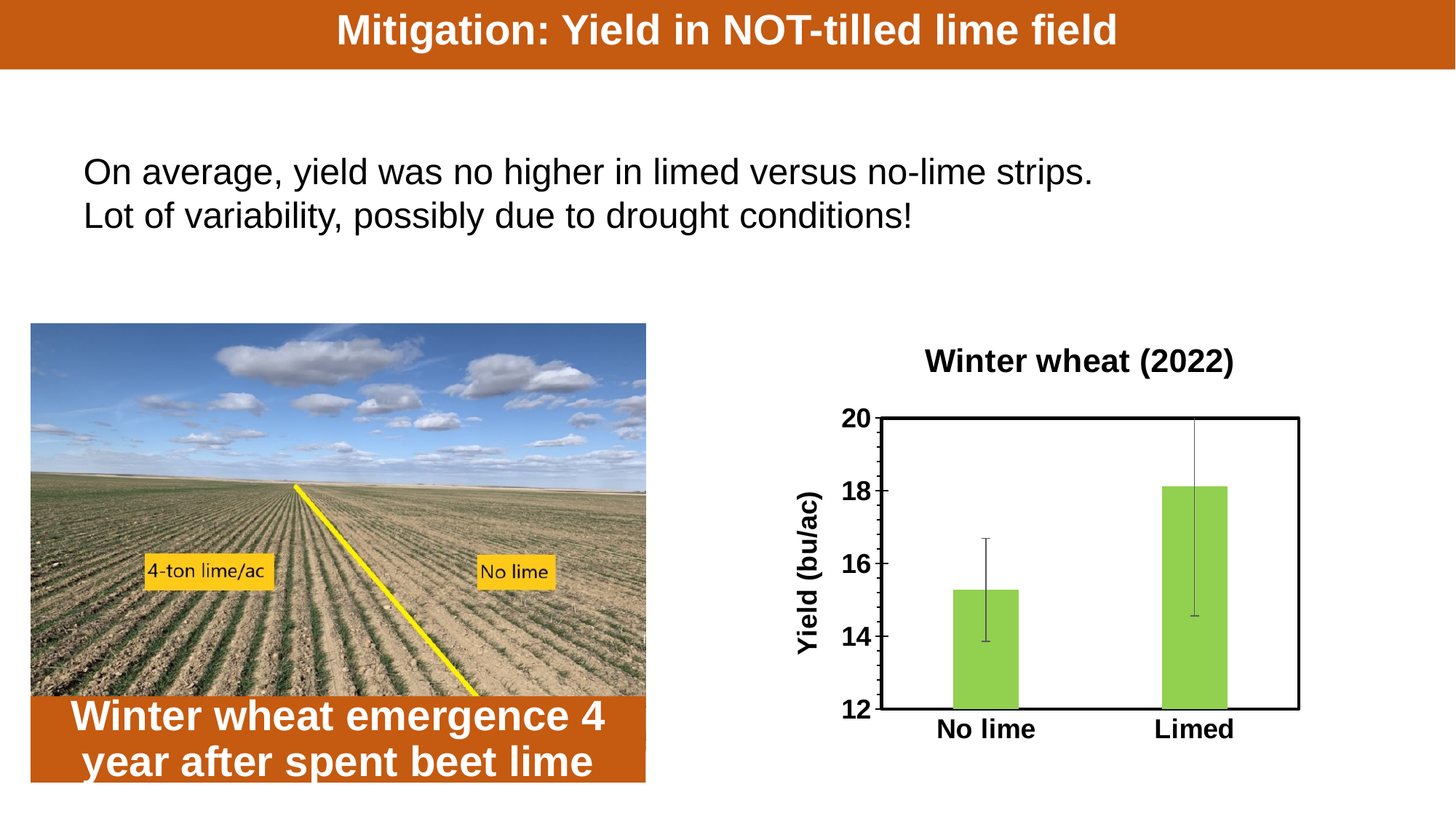
What is the title of the chart on the right side of the slide? Winter wheat (2022) In the Winter wheat (2022) chart, which bar is taller, No lime or Limed? Limed How many categories are plotted on the x axis of the Winter wheat (2022) chart? 2 Which category has the highest yield in the Winter wheat (2022) chart? Limed What kind of chart is shown under the title "Winter wheat (2022)"? bar chart What is the label of the y axis in the Winter wheat (2022) chart? Yield (bu/ac) In the Winter wheat (2022) chart, is the yield for Limed greater or less than 20 bu/ac? less In the Winter wheat (2022) chart, is the yield for Limed greater or less than 16 bu/ac? greater Which category has the lowest yield in the Winter wheat (2022) chart? No lime In the Winter wheat (2022) chart, is the yield for No lime greater or less than 16 bu/ac? less